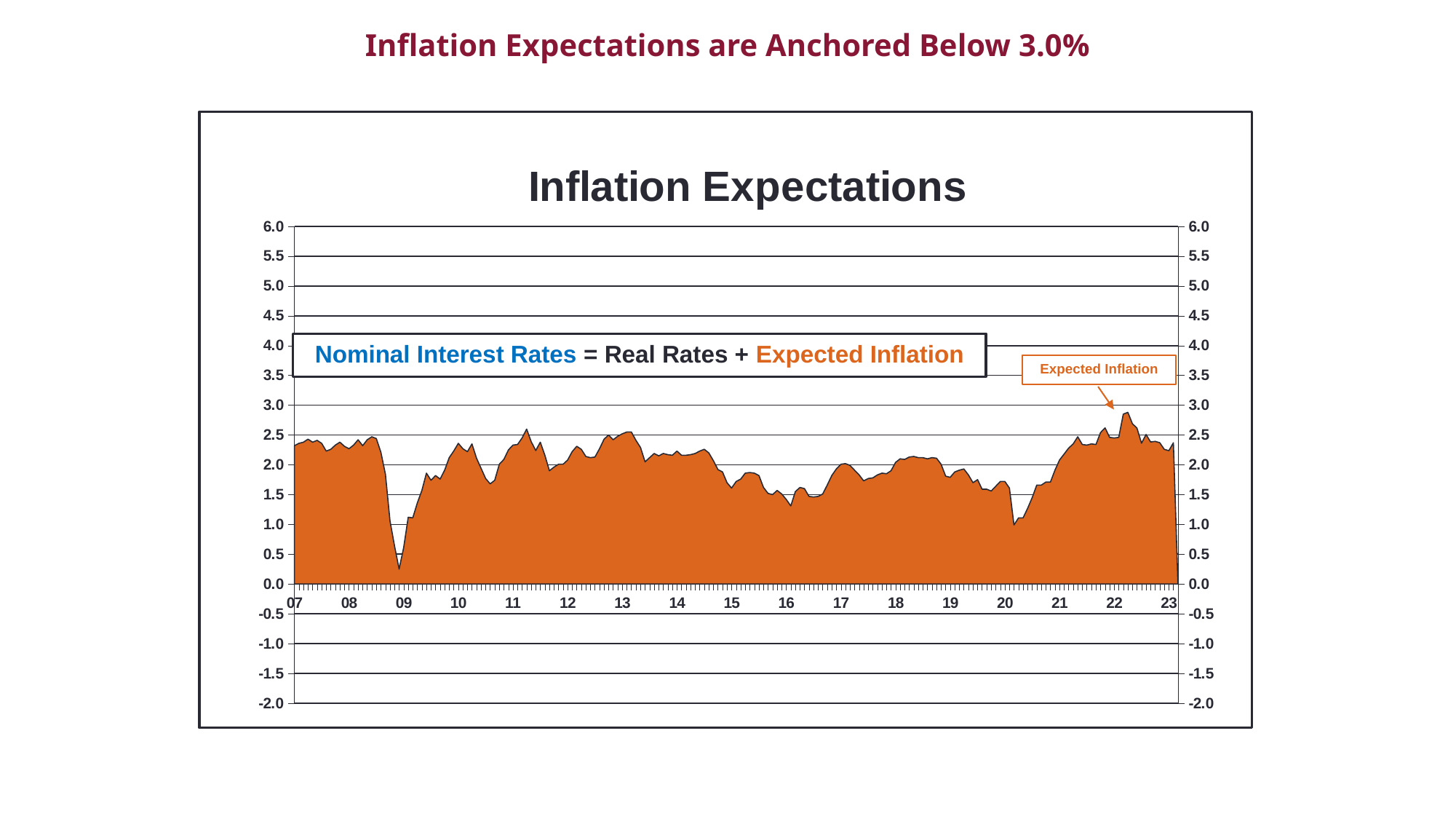
What is the highest value shown on the y axis? 6.0 What kind of chart is shown on the slide? area chart What series is labelled by the callout box on the chart? Expected Inflation Is the value of Expected Inflation at the start of 2007 greater or less than 2.0? greater Is the value of Expected Inflation at the low point in 2009 greater or less than 1.0? less Is the peak value of Expected Inflation in 2022 greater or less than 3.0? less In which year label does Expected Inflation reach its highest point on the chart? 22 How many year labels are shown on the x axis? 17 What is the lowest value shown on the y axis? -2.0 What is the title of the chart? Inflation Expectations Does Expected Inflation rise or fall between 2020 and 2022? rise